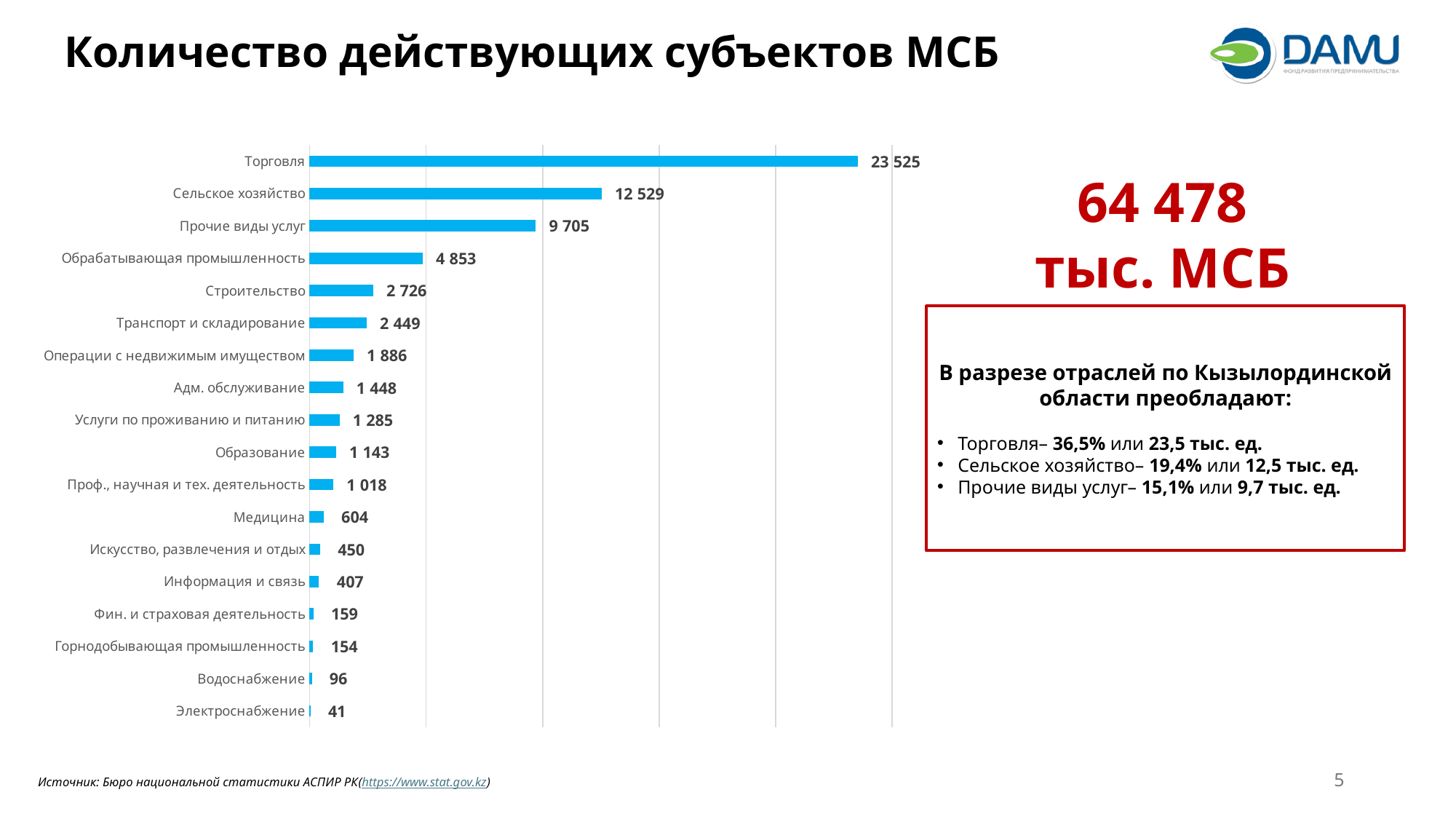
What is the difference between the values for Торговля and Сельское хозяйство? 10 996 What is the value for Обрабатывающая промышленность? 4 853 What is the title of the slide containing the chart? Количество действующих субъектов МСБ What is the value for Медицина? 604 How many categories are shown in the chart? 18 Which category has the lowest value? Электроснабжение What is the value for Торговля? 23 525 What is the value for Водоснабжение? 96 Which is larger, the value for Образование or the value for Проф., научная и тех. деятельность? Образование What is the difference between the values for Строительство and Транспорт и складирование? 277 What kind of chart is shown on the slide? Bar chart Which category has the highest value? Торговля